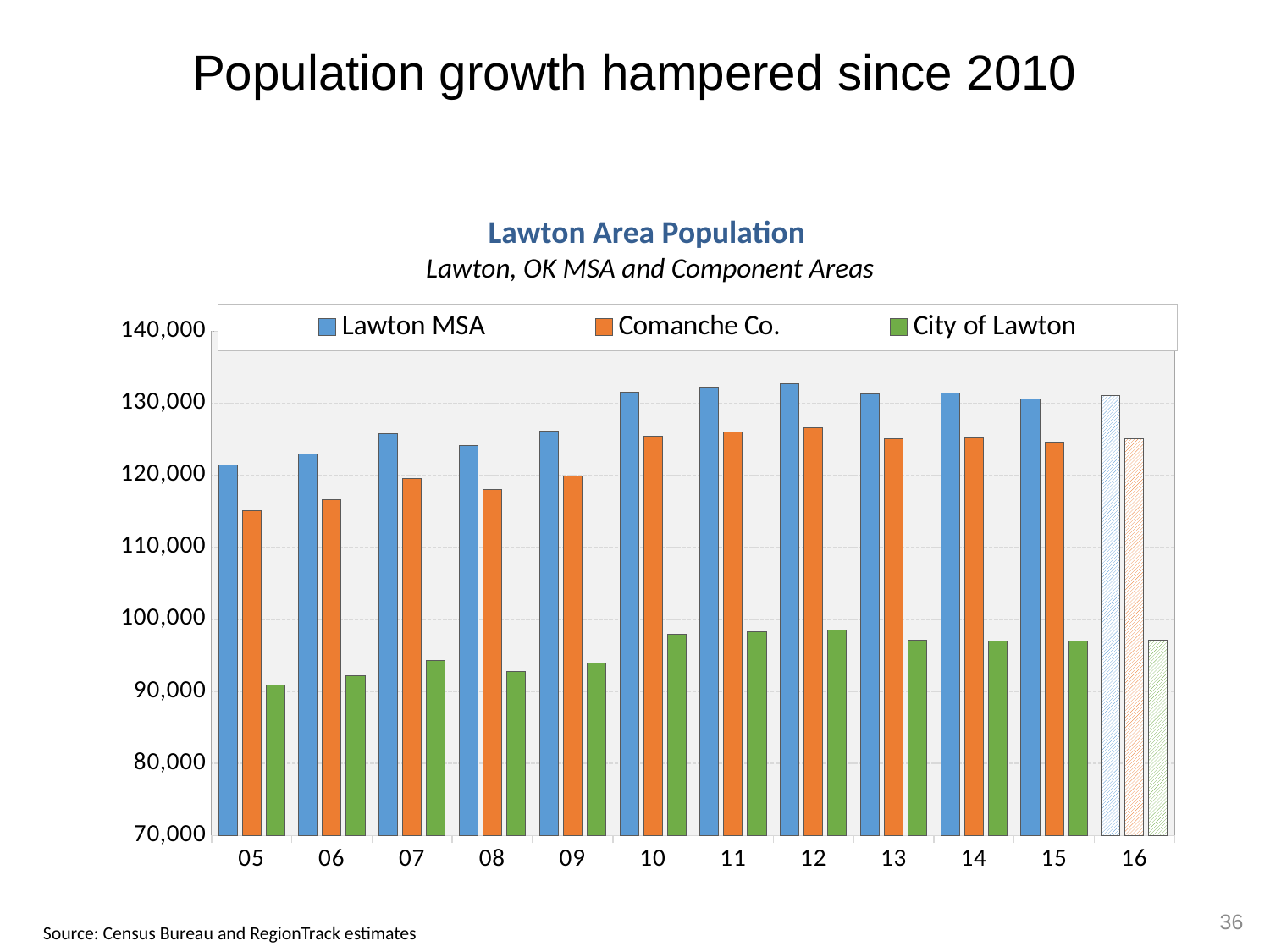
Do the Lawton MSA values rise or fall from 05 to 12? rise Which year has the lowest Lawton MSA value? 05 Is the Comanche Co. value for 05 greater or less than 110,000? greater Which year has the highest Lawton MSA value? 12 Which is larger, the Lawton MSA value for 09 or for 10? 10 Is the City of Lawton value for 10 greater or less than 100,000? less How many series does the legend list? 3 What kind of chart is shown on the slide? bar chart What is the title of the chart? Lawton Area Population How many years are shown on the x axis? 12 Which year has the lowest Comanche Co. value? 05 Is the Lawton MSA value for 05 greater or less than 130,000? less